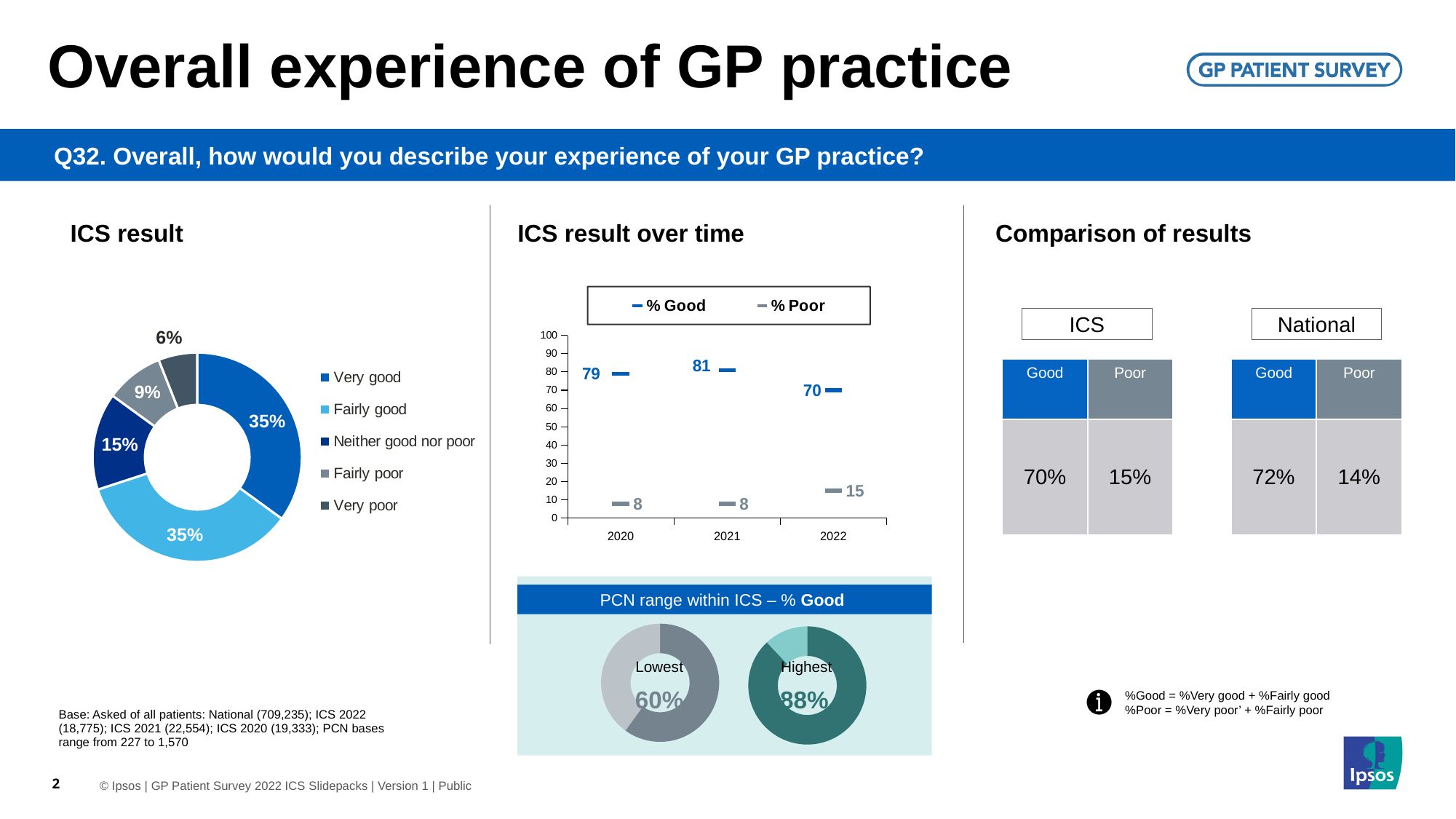
In the PCN range within ICS – % Good section, what is the highest PCN value? 88% In the ICS result over time chart, which year had the highest % Good value? 2021 In the ICS result donut chart, what percentage of patients said their experience was 'Very poor'? 6% In the ICS result donut chart, which category has the smallest share? Very poor In the ICS result donut chart, what percentage of patients said their experience was 'Very good'? 35% In the ICS result over time chart, what was the % Poor value in 2022? 15 In the Comparison of results section, which is larger, the ICS % Good or the National % Good? National In the ICS result over time chart, how many series does the legend list? 2 In the ICS result over time chart, by how much did % Good fall from 2021 to 2022? 11 In the ICS result donut chart, how many categories does the legend list? 5 In the ICS result over time chart, what was the % Good value in 2021? 81 In the ICS result donut chart, what is the difference between the 'Neither good nor poor' share and the 'Fairly poor' share? 6%